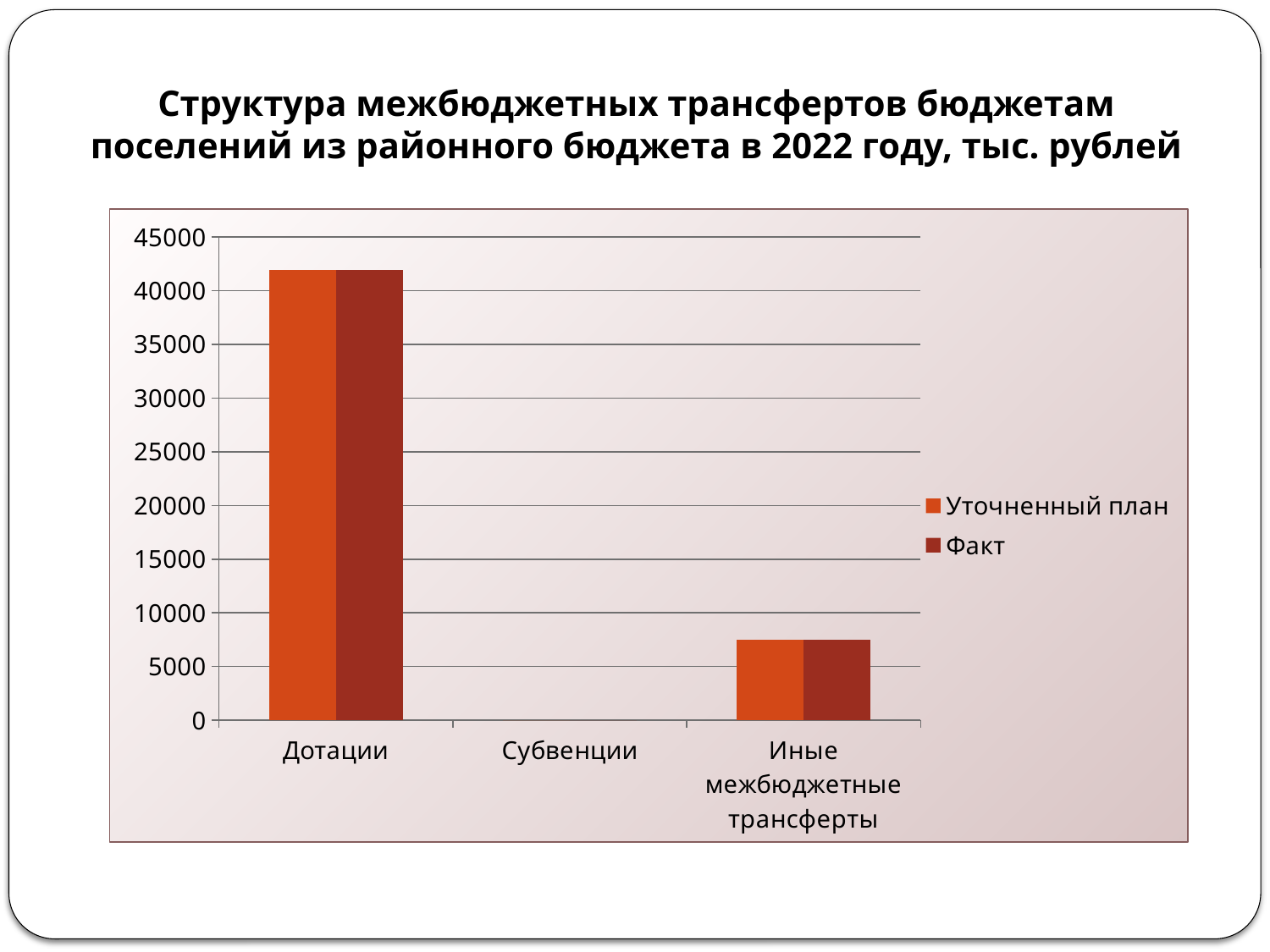
What are the two series named in the chart's legend? Уточненный план and Факт How many categories are shown on the x axis of the chart? 3 Is the value of Факт for Дотации greater or less than 45000? less Which is larger: the Факт value for Дотации or the Факт value for Иные межбюджетные трансферты? Дотации Which category has the highest values in the chart? Дотации What kind of chart is shown on the slide? Bar chart Is the value of Факт for Иные межбюджетные трансферты greater or less than 5000? greater Is the value of Уточненный план for Дотации greater or less than 40000? greater What is the title of the chart on the slide? Структура межбюджетных трансфертов бюджетам поселений из районного бюджета в 2022 году, тыс. рублей Which category has the lowest values in the chart? Субвенции How many series does the chart's legend list? 2